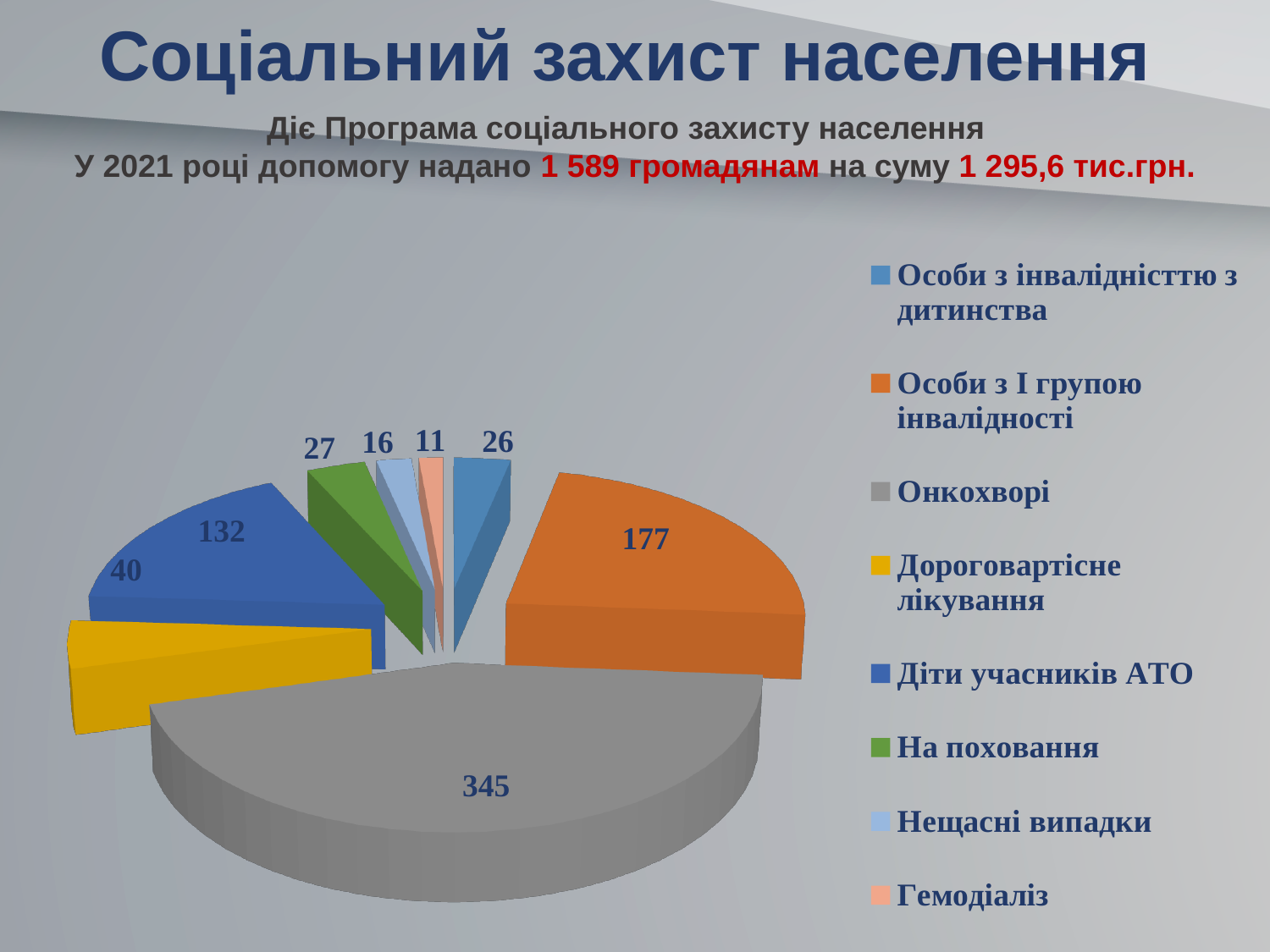
What is the difference between the values for Онкохворі and Особи з І групою інвалідності? 168 Which category has the smallest slice in the pie chart? Гемодіаліз Which is larger: the value for Дороговартісне лікування or the value for На поховання? Дороговартісне лікування What is the value for Особи з І групою інвалідності? 177 What is the value for Гемодіаліз? 11 Which category has the largest slice in the pie chart? Онкохворі How many categories does the legend of the pie chart list? 8 What colour is the slice for Дороговартісне лікування? Yellow What is the total of all slices in the pie chart? 774 What is the value for Онкохворі in the pie chart? 345 What type of chart is shown on the slide? Pie chart What is the value for Діти учасників АТО? 132